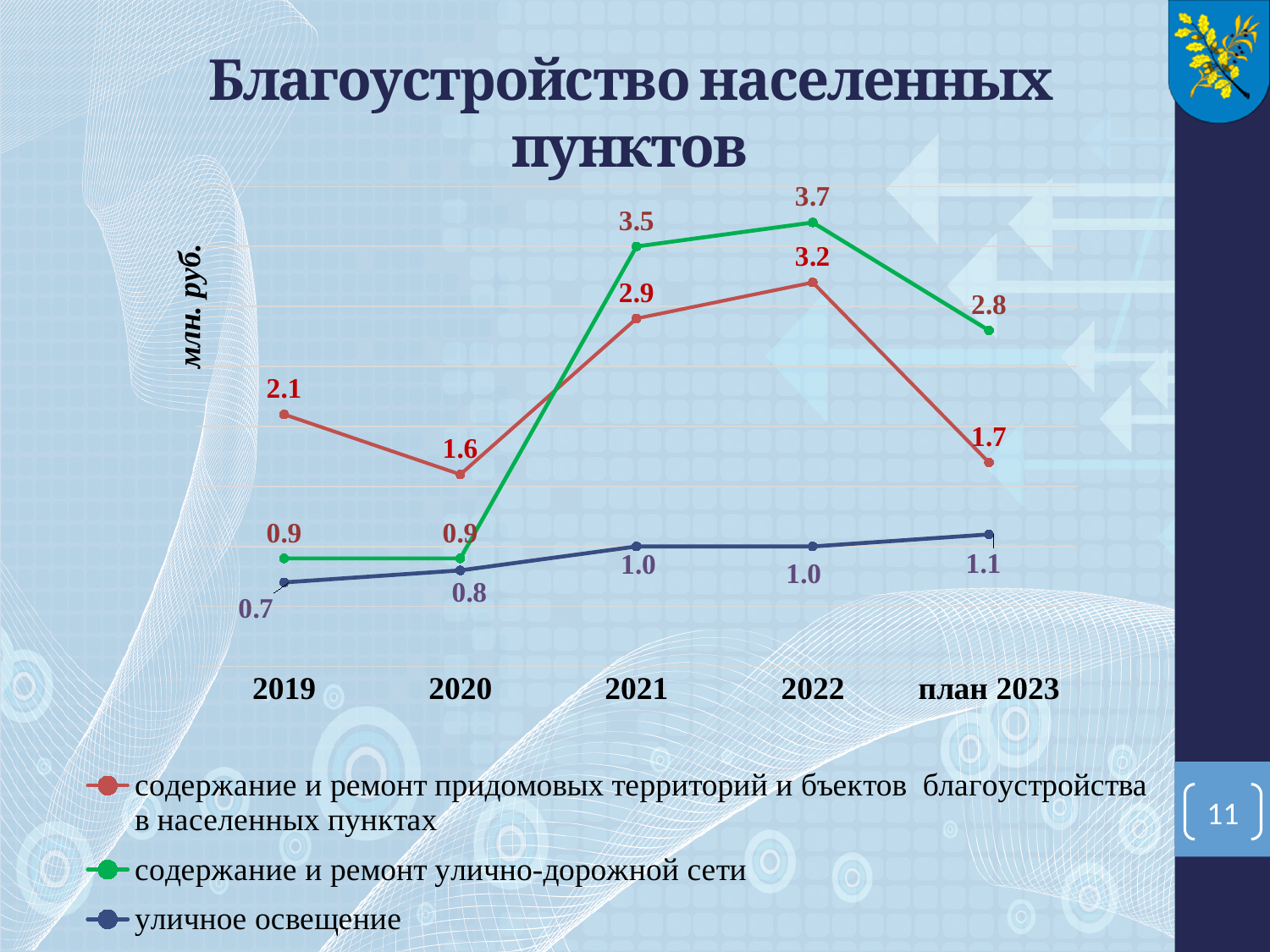
What is the value for 'содержание и ремонт придомовых территорий и объектов благоустройства в населенных пунктах' in 2021? 2.9 In which year is the value for 'содержание и ремонт улично-дорожной сети' highest? 2022 What type of chart is shown on the slide? line chart Does the value for 'уличное освещение' rise or fall from 2019 to план 2023? rise In which year is the value for 'содержание и ремонт придомовых территорий и объектов благоустройства в населенных пунктах' lowest? 2020 What is the value for 'содержание и ремонт улично-дорожной сети' in 2022? 3.7 How many points along the x axis does the chart have? 5 What is the difference between the 2022 and план 2023 values for 'содержание и ремонт придомовых территорий и объектов благоустройства в населенных пунктах'? 1.5 What is the value for 'уличное освещение' in 2019? 0.7 Which series has the larger value in 2019: 'содержание и ремонт улично-дорожной сети' or 'содержание и ремонт придомовых территорий и объектов благоустройства в населенных пунктах'? содержание и ремонт придомовых территорий и объектов благоустройства в населенных пунктах What unit is shown on the vertical axis label? млн. руб. How many series does the legend list? 3